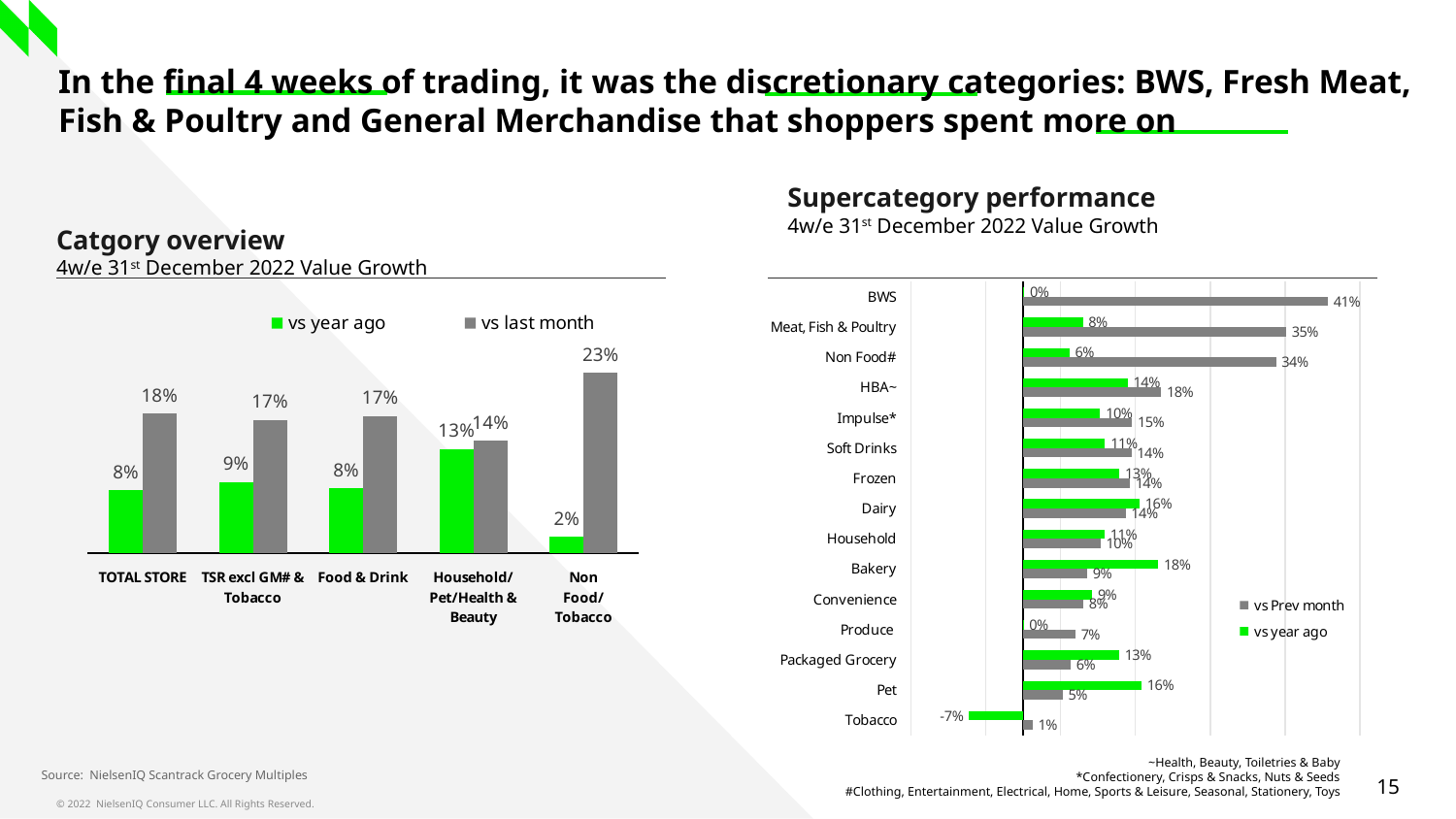
In the Catgory overview chart, which category has the lowest vs year ago value? Non Food/Tobacco In the Catgory overview chart, what is the vs last month value for Non Food/Tobacco? 23% In the Supercategory performance chart, what is the vs year ago value for Tobacco? -7% In the Supercategory performance chart, how many categories are listed? 15 In the Catgory overview chart, what is the difference between the vs last month and vs year ago values for TOTAL STORE? 10% In the Supercategory performance chart, which is larger for Pet: the vs year ago value or the vs Prev month value? vs year ago In the Supercategory performance chart, how many series does the legend list? 2 In the Catgory overview chart, what is the vs year ago value for Household/Pet/Health & Beauty? 13% In the Catgory overview chart, how many categories are shown on the x axis? 5 In the Supercategory performance chart, what is the vs Prev month value for BWS? 41% What type of chart is the Supercategory performance chart? Bar chart In the Supercategory performance chart, which category has the highest vs year ago value? Bakery